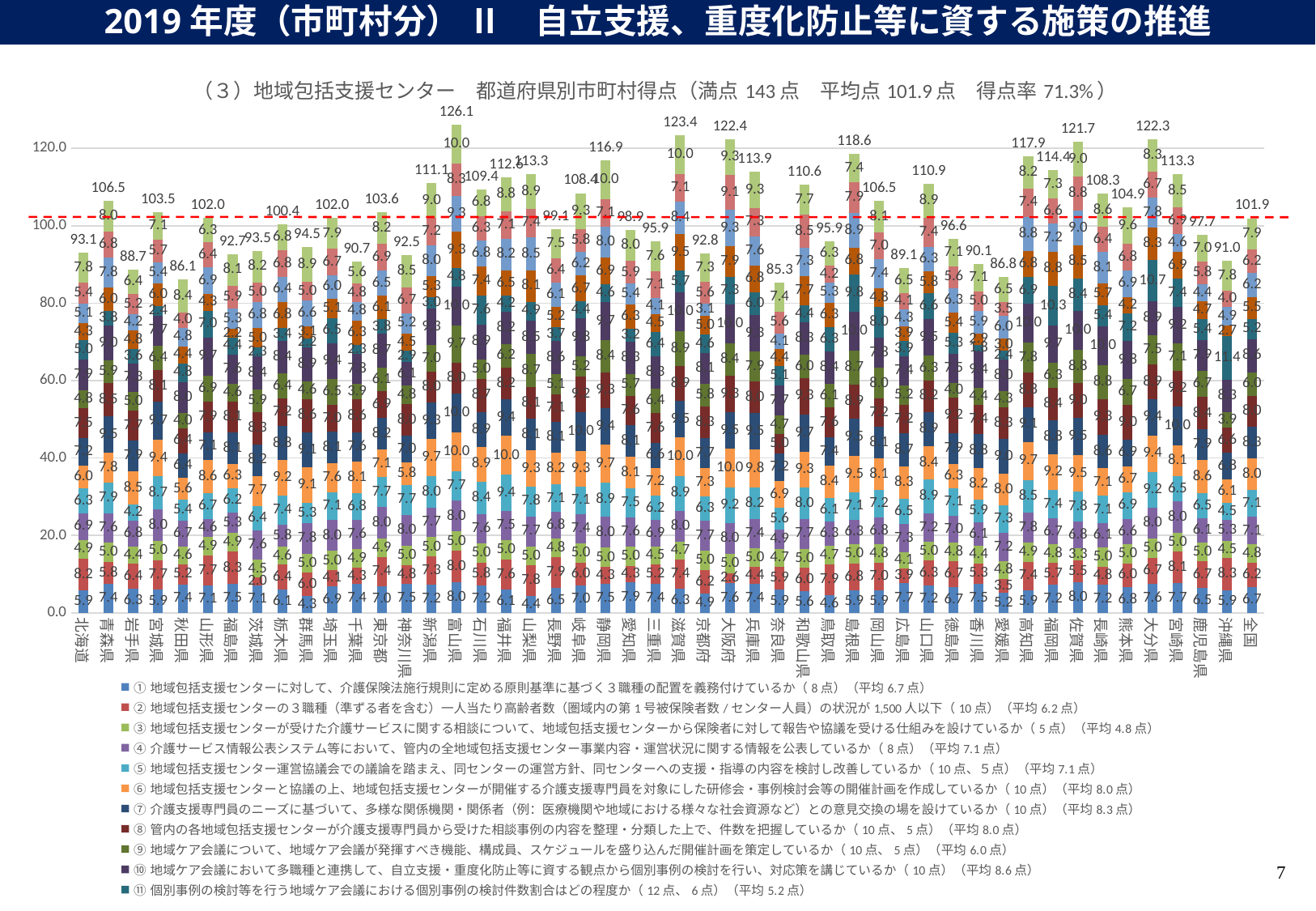
What kind of chart is shown on the slide? Stacked bar chart Which has a higher total score, 大阪府 or 兵庫県? 大阪府 What is the difference between the total scores of 富山県 (126.1) and 奈良県 (85.3)? 40.8 Which prefecture has the lowest total score? 奈良県 (85.3) How many bars (categories) are plotted along the x axis? 48 Is the total score for 秋田県 greater or less than 100.0? less What is the total score for 滋賀県? 123.4 What average score (平均点) is stated in the chart title? 101.9 点 Which prefecture has the highest total score? 富山県 (126.1) What is the total score shown for 全国? 101.9 How many series does the legend list? 11 What is the total score for 北海道? 93.1